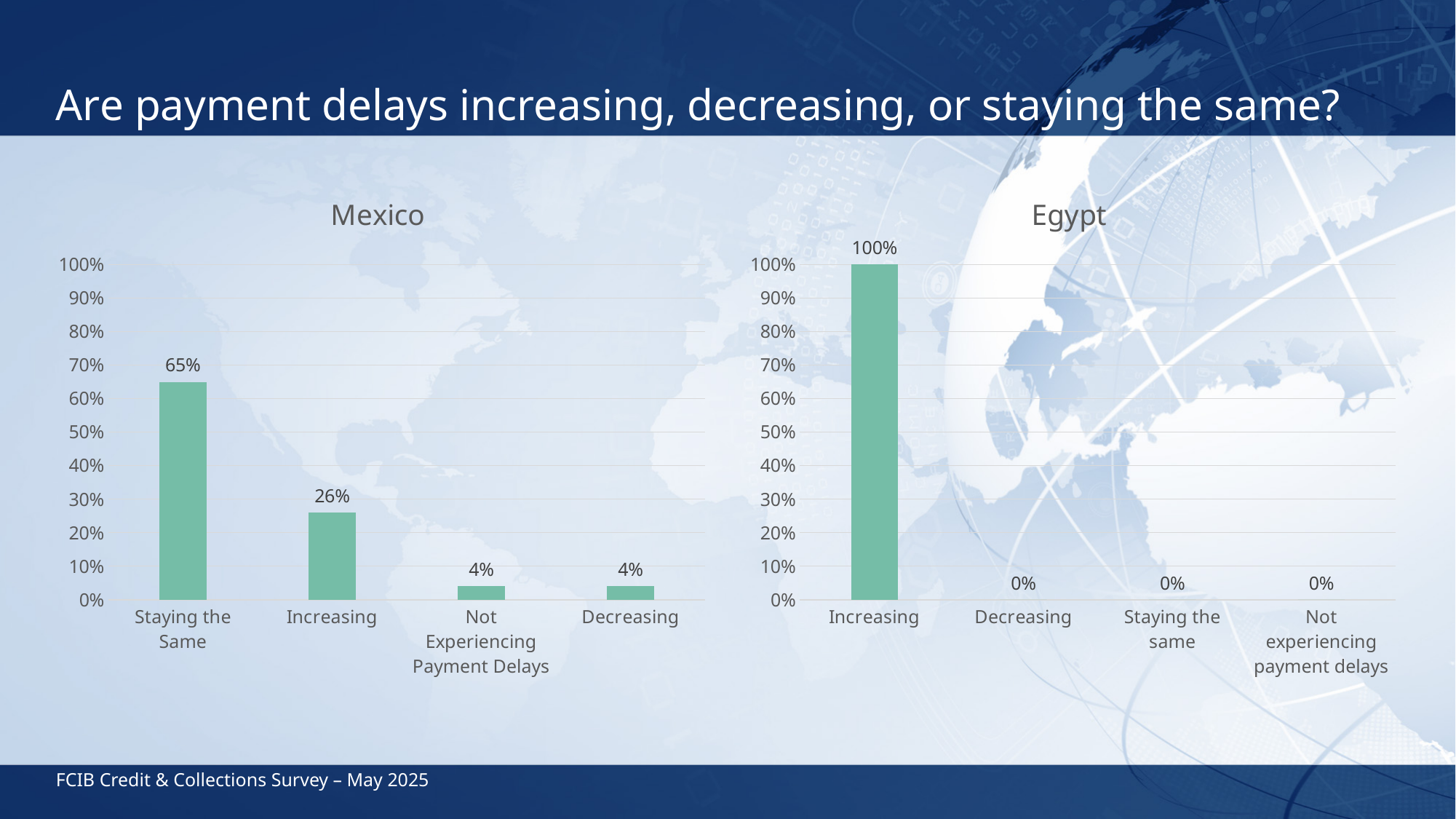
In the Egypt chart, which category has the highest value? Increasing In the Egypt chart, what is the value for Increasing? 100% How many categories are shown in the Egypt chart? 4 How many categories are shown in the Mexico chart? 4 What kind of chart is the Egypt chart? Bar chart In the Mexico chart, what is the difference between Staying the Same and Increasing? 39% In the Mexico chart, which is larger, Increasing or Decreasing? Increasing In the Mexico chart, which category has the highest value? Staying the Same In the Mexico chart, what is the value for Increasing? 26% In the Egypt chart, what is the value for Decreasing? 0% In the Mexico chart, what is the value for Not Experiencing Payment Delays? 4% In the Mexico chart, what is the value for Staying the Same? 65%